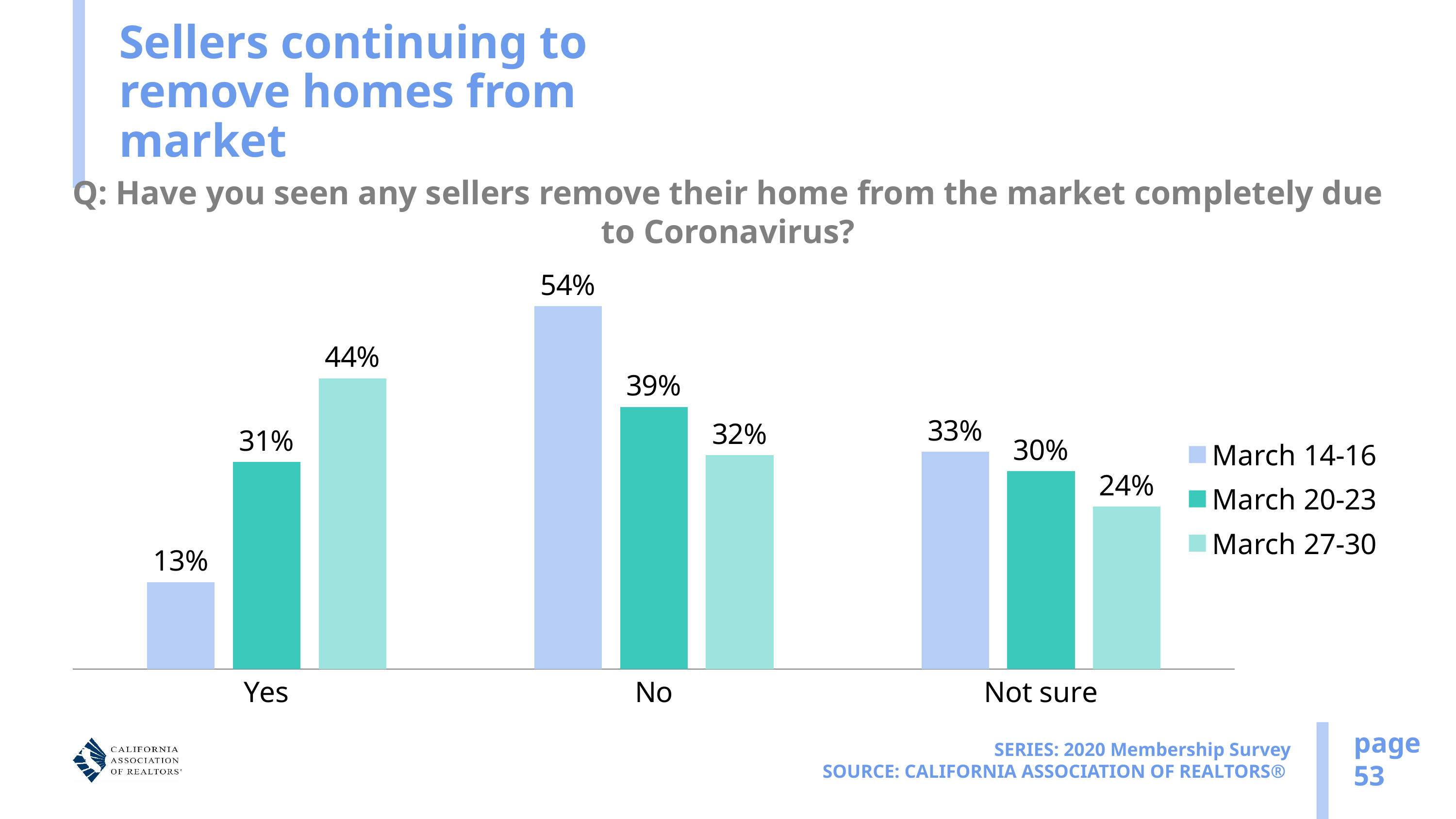
What is the value for No in the March 27-30 series? 32% Which category has the lowest value in the March 27-30 series? Not sure Across the three survey periods, do the values for Yes rise or fall over time? Rise What is the difference between the March 14-16 and March 20-23 values for No? 15% Which category has the highest value in the March 14-16 series? No Which is larger for Not sure: the March 14-16 value or the March 27-30 value? March 14-16 How many series does the legend list? 3 What is the value for Yes in the March 14-16 series? 13% What is the difference between the March 27-30 and March 14-16 values for Yes? 31% What kind of chart is shown on the slide? Bar chart How many categories are shown on the x axis? 3 What is the value for Not sure in the March 20-23 series? 30%